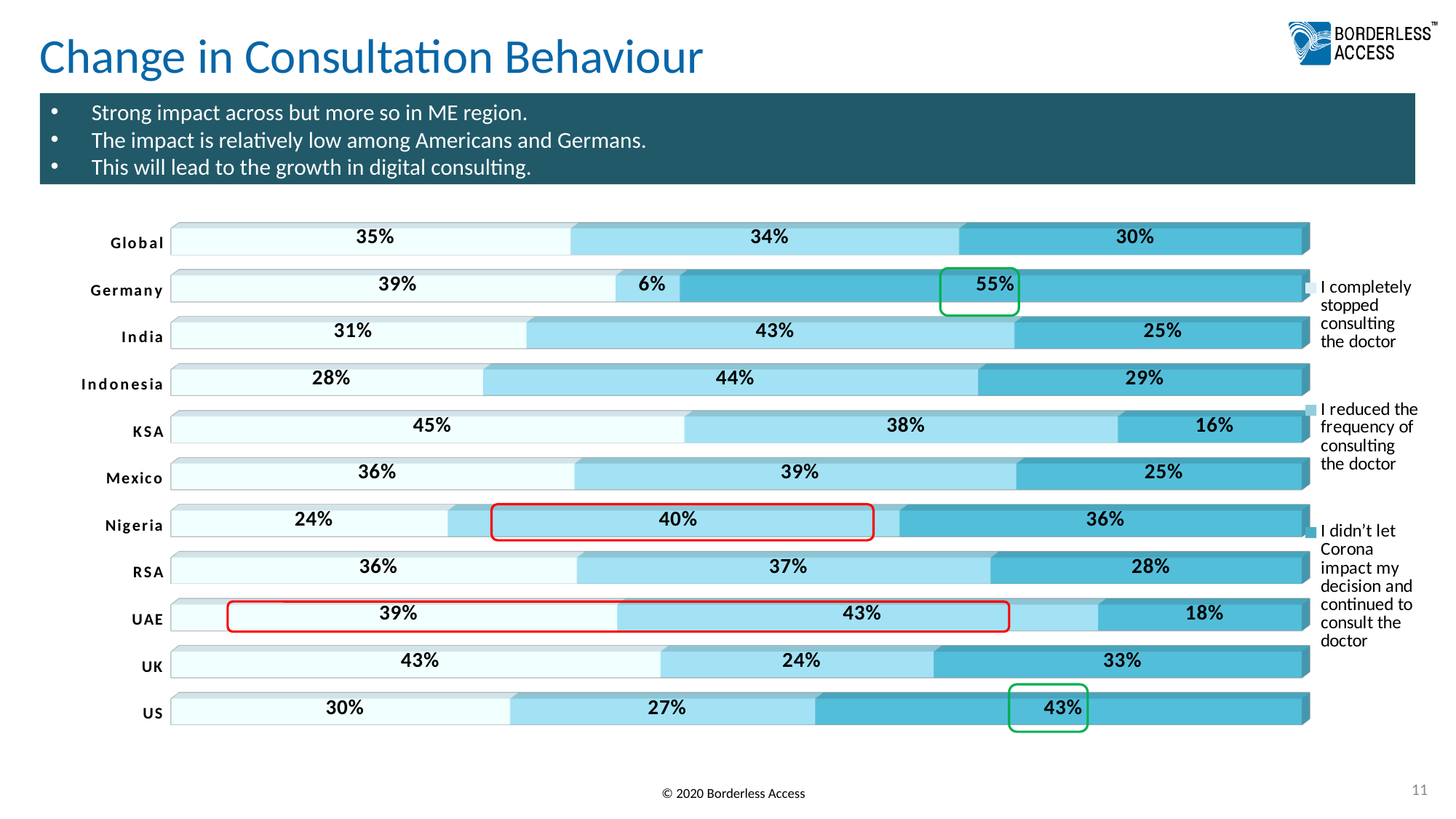
How many countries/regions are listed on the chart? 11 What kind of chart is shown on the slide? Stacked bar chart What is the title of the slide containing the chart? Change in Consultation Behaviour Which is larger: the 'I reduced the frequency of consulting the doctor' value for UAE or for UK? UAE What is the value for 'I reduced the frequency of consulting the doctor' for Nigeria? 40% What percentage of respondents in KSA said they completely stopped consulting the doctor? 45% Which country has the lowest share of respondents who reduced the frequency of consulting the doctor? Germany What is the difference between the US and Global values for 'I didn't let Corona impact my decision and continued to consult the doctor'? 13% How many series does the legend list? 3 What is the total of the three segments for the Indonesia bar? 101% Which country has the highest share of respondents who completely stopped consulting the doctor? KSA What percentage of respondents in Germany said they didn't let Corona impact their decision and continued to consult the doctor? 55%